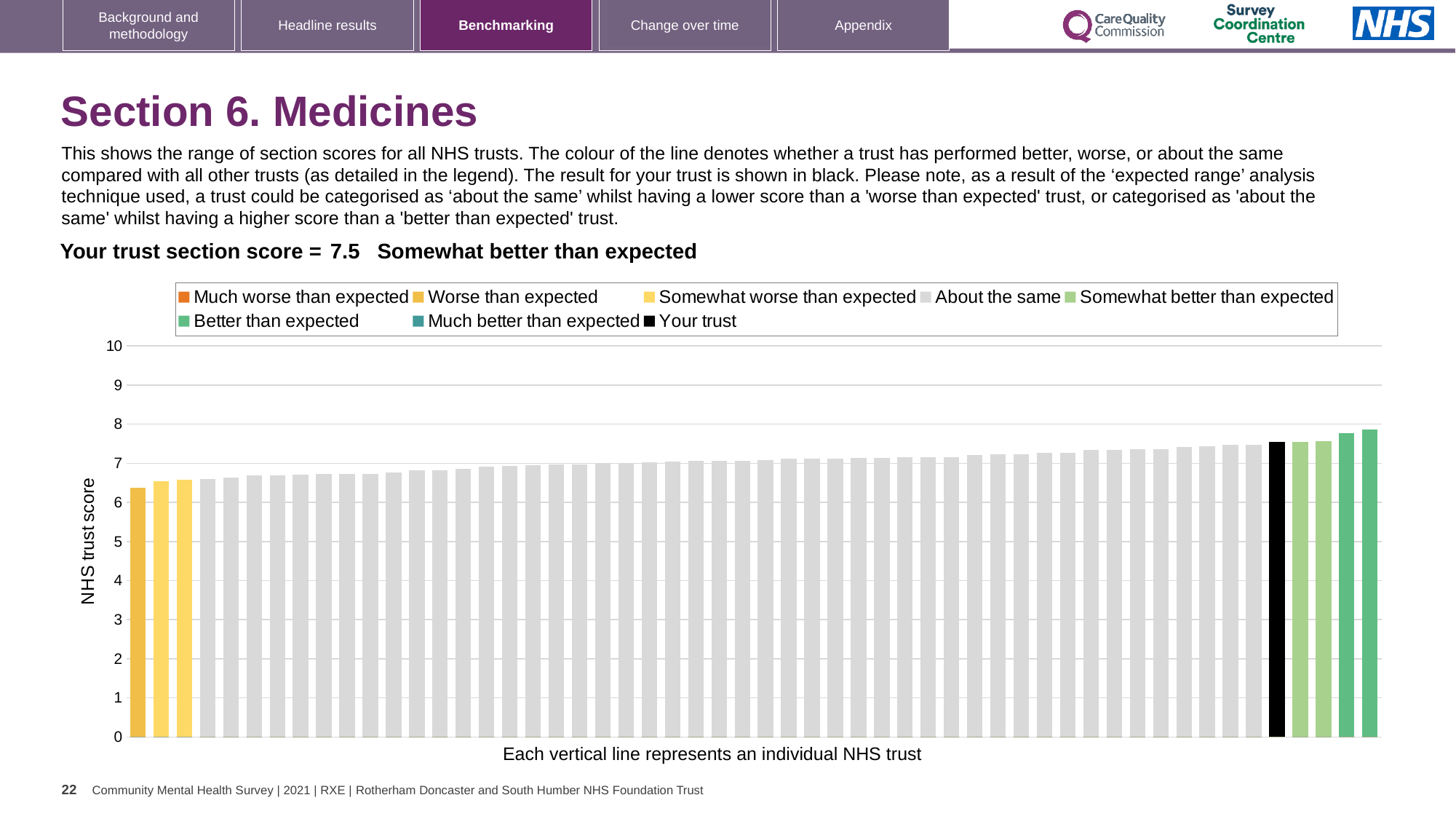
Is the value of the leftmost bar greater or less than 7? less How many entries does the chart legend list? 8 Which is larger, the leftmost bar or the rightmost bar? the rightmost bar According to the legend, what does a black bar represent? Your trust Do the bar values rise or fall moving from left to right along the x axis? rise Which performance category is your trust placed in for Section 6. Medicines? Somewhat better than expected What is the section score for your trust shown on the slide? 7.5 What is the label on the vertical axis of the chart? NHS trust score What kind of chart is shown on the slide? bar chart Is the value of the leftmost bar on the chart greater or less than 6? greater Is the value of the tallest bar on the chart greater or less than 8? less